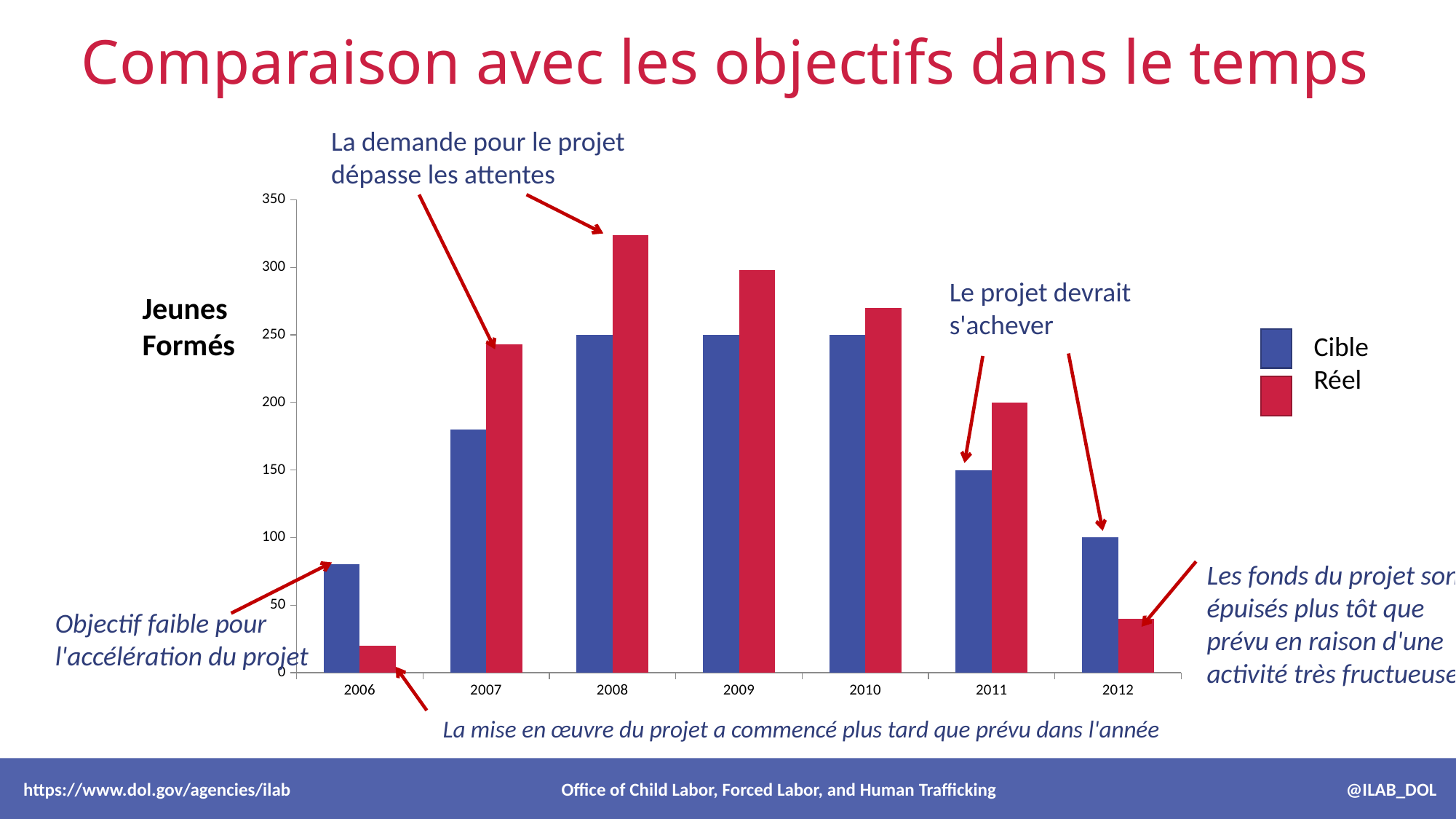
In 2008, which is larger, Cible or Réel? Réel In 2012, which is larger, Cible or Réel? Cible How many series does the legend list? 2 In which year is the Réel value highest? 2008 In which year is the Réel value lowest? 2006 Does the Cible value rise or fall from 2010 to 2012? fall Is the Réel value for 2008 greater or less than 300? greater What is the Cible value for 2010? 250 How many years are shown on the x axis? 7 What is the Cible value for 2012? 100 What is the Cible value for 2011? 150 What kind of chart is shown on the slide? bar chart